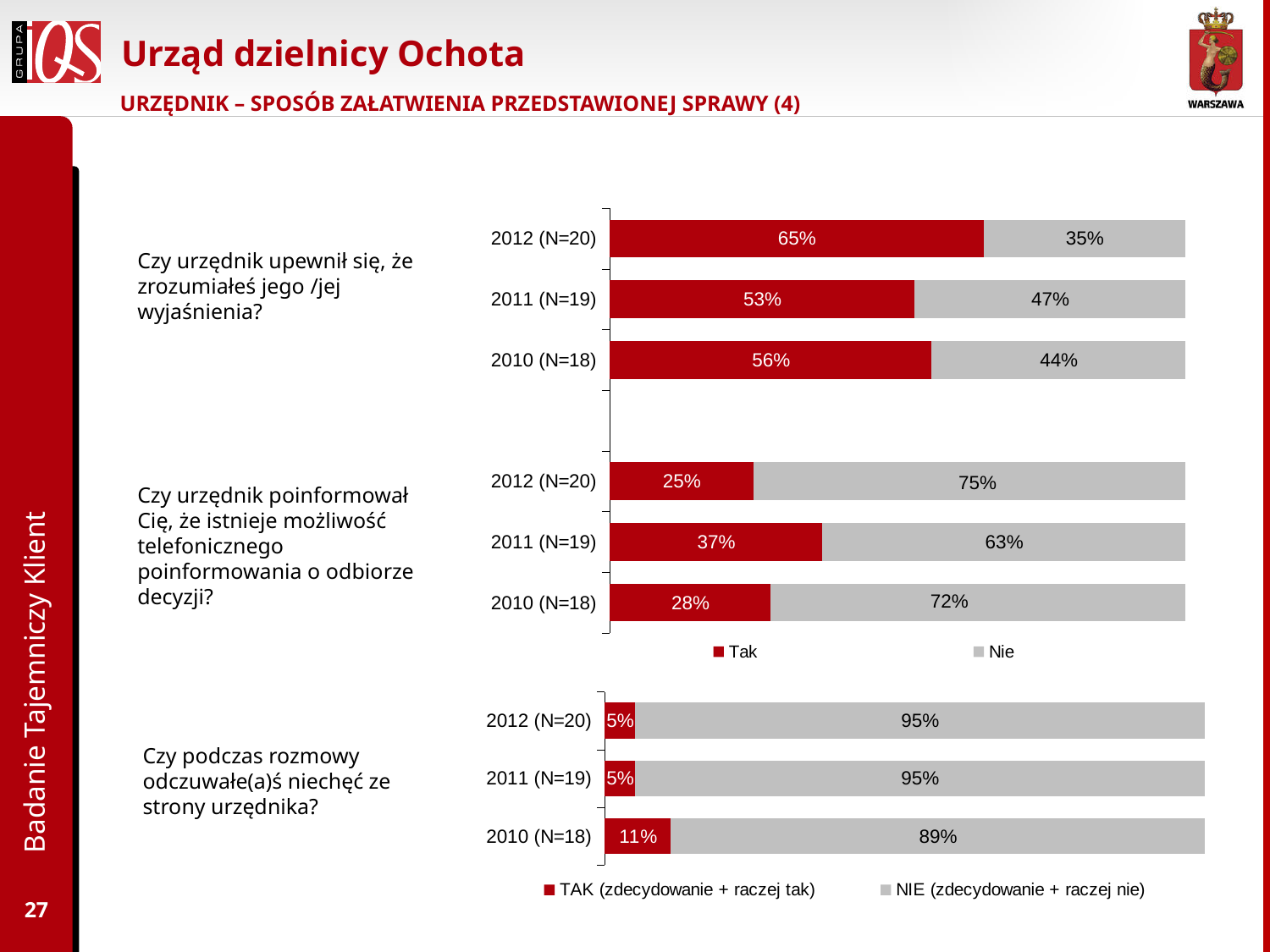
In the top chart, for the question 'Czy urzędnik poinformował Cię, że istnieje możliwość telefonicznego poinformowania o odbiorze decyzji?', what is the 'Tak' value for 2010 (N=18)? 28% In the bottom chart ('Czy podczas rozmowy odczuwałe(a)ś niechęć ze strony urzędnika?'), what is the total of the stacked bar for 2011 (N=19)? 100% What kind of chart is used on this slide? Stacked horizontal bar chart In the bottom chart ('Czy podczas rozmowy odczuwałe(a)ś niechęć ze strony urzędnika?'), what is the 'NIE' value for 2012 (N=20)? 95% In the top chart, for the question 'Czy urzędnik poinformował Cię, że istnieje możliwość telefonicznego poinformowania o odbiorze decyzji?', is the 'Nie' value for 2012 (N=20) larger or smaller than for 2011 (N=19)? larger In the top chart, for the question 'Czy urzędnik upewnił się, że zrozumiałeś jego /jej wyjaśnienia?', what is the 'Tak' value for 2012 (N=20)? 65% In the bottom chart ('Czy podczas rozmowy odczuwałe(a)ś niechęć ze strony urzędnika?'), what is the 'TAK' value for 2010 (N=18)? 11% In the top chart, for the question 'Czy urzędnik upewnił się, że zrozumiałeś jego /jej wyjaśnienia?', which year has the lowest 'Tak' value? 2011 (N=19) How many series does the legend of the bottom chart list? 2 In the top chart, for the question 'Czy urzędnik upewnił się, że zrozumiałeś jego /jej wyjaśnienia?', what is the 'Nie' value for 2011 (N=19)? 47% In the top chart, for the question 'Czy urzędnik upewnił się, że zrozumiałeś jego /jej wyjaśnienia?', what is the difference between the 'Tak' values for 2012 (N=20) and 2011 (N=19)? 12 percentage points In the top chart, for the question 'Czy urzędnik poinformował Cię, że istnieje możliwość telefonicznego poinformowania o odbiorze decyzji?', which year has the highest 'Tak' value? 2011 (N=19)